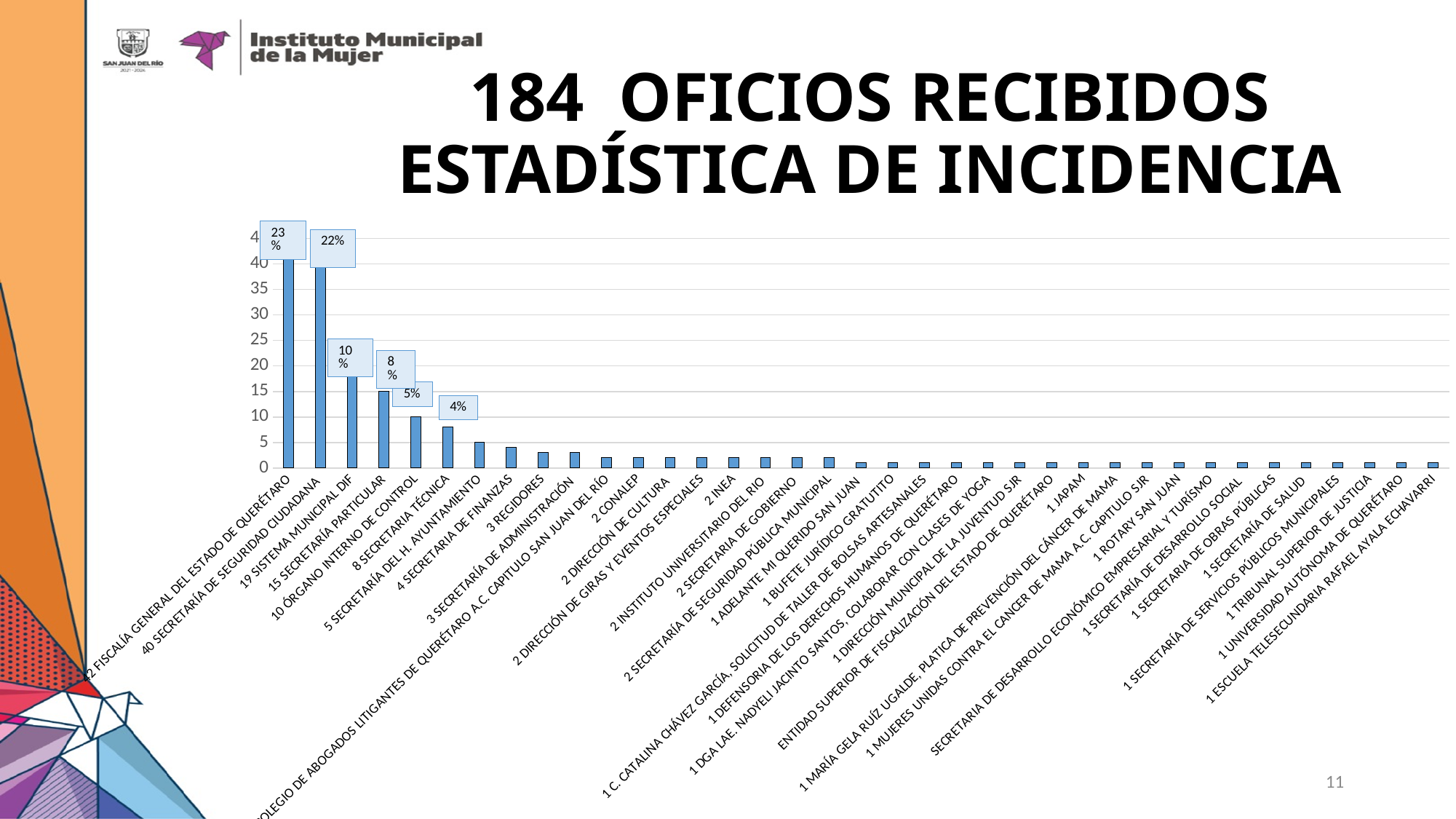
How many oficios are attributed to SISTEMA MUNICIPAL DIF? 19 What is the title of the slide containing the chart? 184 OFICIOS RECIBIDOS ESTADÍSTICA DE INCIDENCIA Which category has the highest value? FISCALÍA GENERAL DEL ESTADO DE QUERÉTARO What type of chart is shown on the slide? bar chart Do the bar values rise or fall from left to right along the x axis? fall Is the value for SISTEMA MUNICIPAL DIF greater or less than 20? less What is the difference between the values for FISCALÍA GENERAL DEL ESTADO DE QUERÉTARO and SECRETARÍA DE SEGURIDAD CIUDADANA? 2 How many oficios are attributed to SECRETARÍA DE SEGURIDAD CIUDADANA? 40 What percentage label is shown above the bar for FISCALÍA GENERAL DEL ESTADO DE QUERÉTARO? 23% Which is larger, the value for SECRETARÍA PARTICULAR or the value for SECRETARIA TÉCNICA? SECRETARÍA PARTICULAR What percentage label is shown for ÓRGANO INTERNO DE CONTROL? 5% How many categories are plotted in the chart? 37